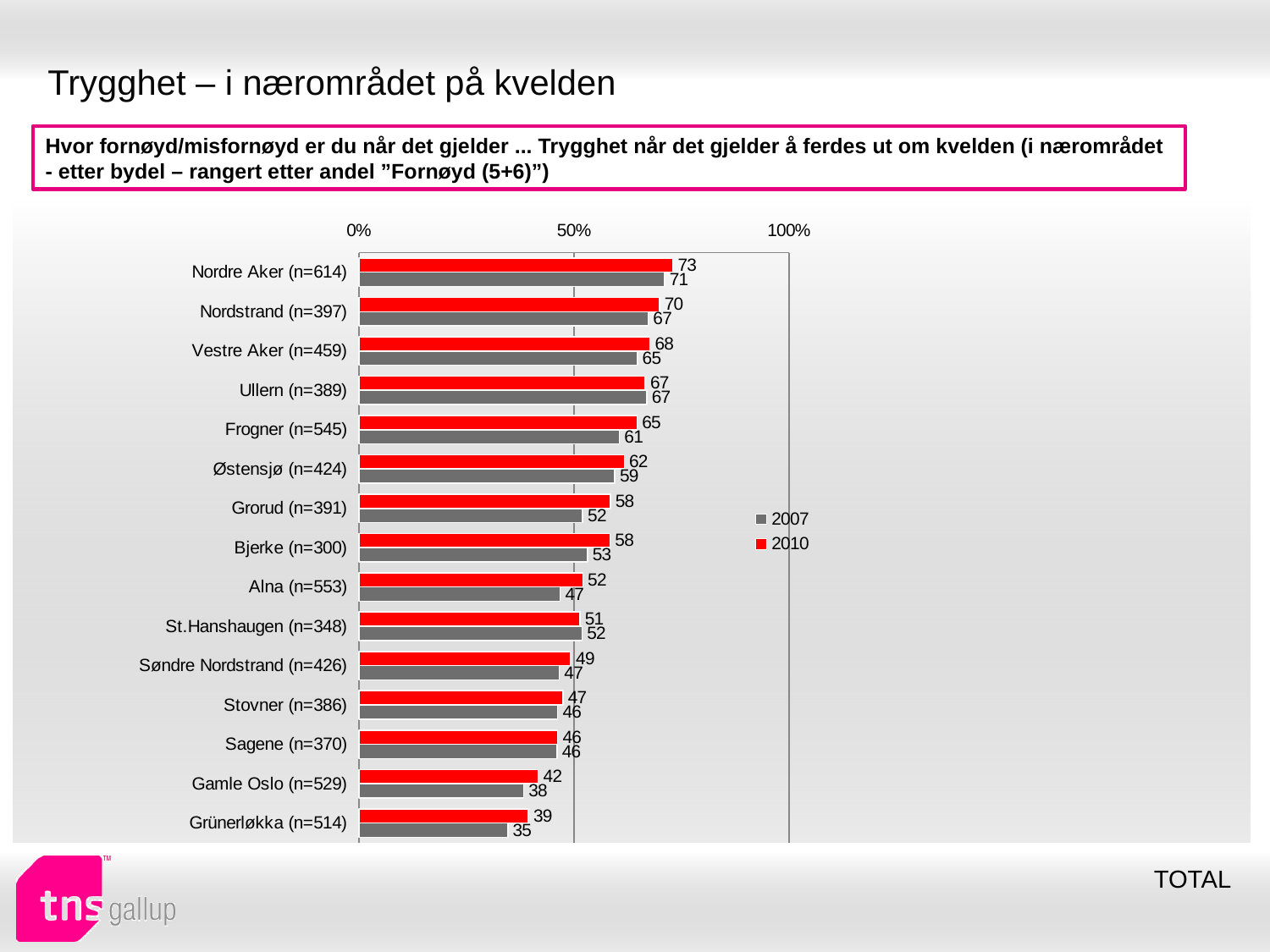
What is the difference between the 2010 and 2007 values for Grorud (n=391)? 6 What is the 2007 value for Grorud (n=391)? 52 Which district has the highest 2010 value? Nordre Aker (n=614) What is the 2010 value for Nordre Aker (n=614)? 73 Is the 2010 value for Frogner (n=545) greater or less than 50%? greater Which is larger for St.Hanshaugen (n=348): the 2007 value or the 2010 value? 2007 What is the 2010 value for Gamle Oslo (n=529)? 42 Which colour represents the 2010 series in the legend? Red How many series does the legend list? 2 What kind of chart is shown on the slide? Bar chart How many districts are shown on the chart? 15 Which district has the lowest 2007 value? Grünerløkka (n=514)